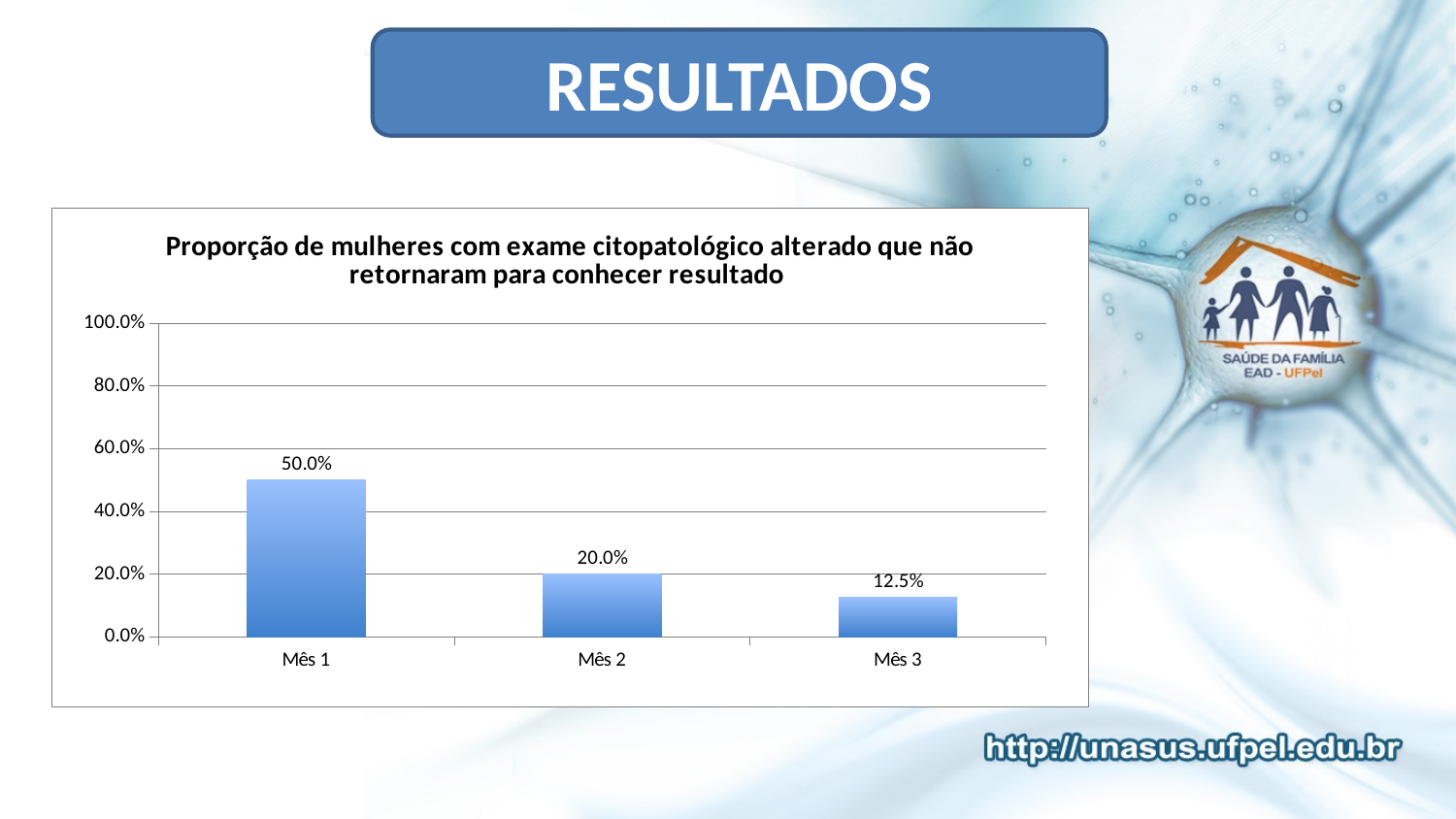
Is the value for Mês 1 greater or less than 40.0%? greater How many months are shown on the x axis? 3 Which is larger, the value for Mês 2 or the value for Mês 3? Mês 2 Which month has the lowest value? Mês 3 What is the value for Mês 2? 20.0% What is the value for Mês 3? 12.5% What is the value for Mês 1? 50.0% What is the difference between the values for Mês 1 and Mês 2? 30.0% What kind of chart is shown on the slide? Bar chart Do the values rise or fall from Mês 1 to Mês 3? Fall What is the difference between the values for Mês 2 and Mês 3? 7.5% Which month has the highest value? Mês 1